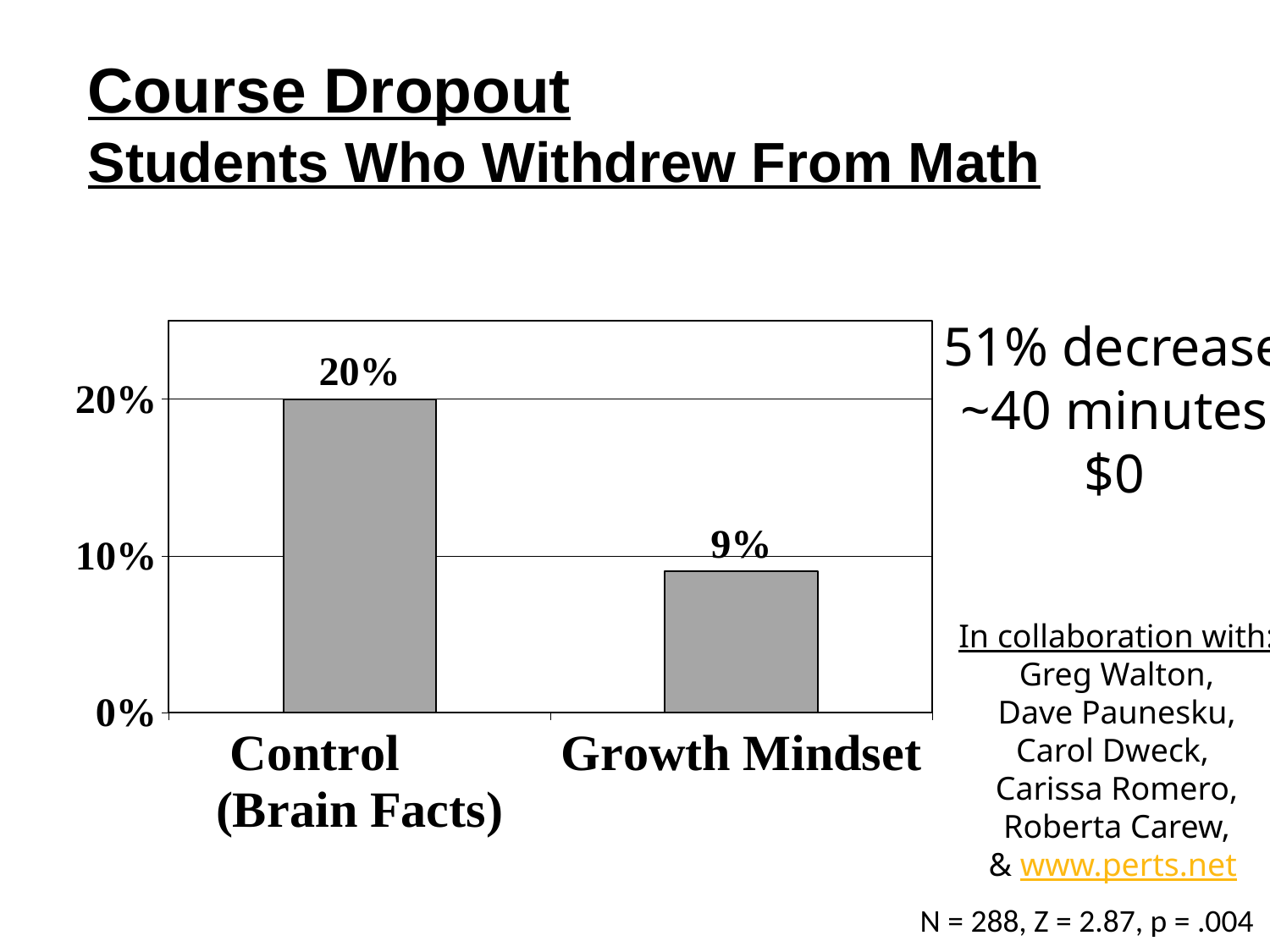
Is the value for Control (Brain Facts) greater or less than 10%? greater What is the value for Control (Brain Facts)? 20% Which is larger, the value for Control (Brain Facts) or the value for Growth Mindset? Control (Brain Facts) Which category has the highest value? Control (Brain Facts) What is the difference between the Control (Brain Facts) value and the Growth Mindset value? 11% Is the value for Growth Mindset greater or less than 10%? less What kind of chart is shown on the slide? bar chart How many categories are shown on the chart? 2 What is the value for Growth Mindset? 9% Do the values rise or fall from Control (Brain Facts) to Growth Mindset? fall Which category has the lowest value? Growth Mindset What is the highest tick label shown on the vertical axis? 20%